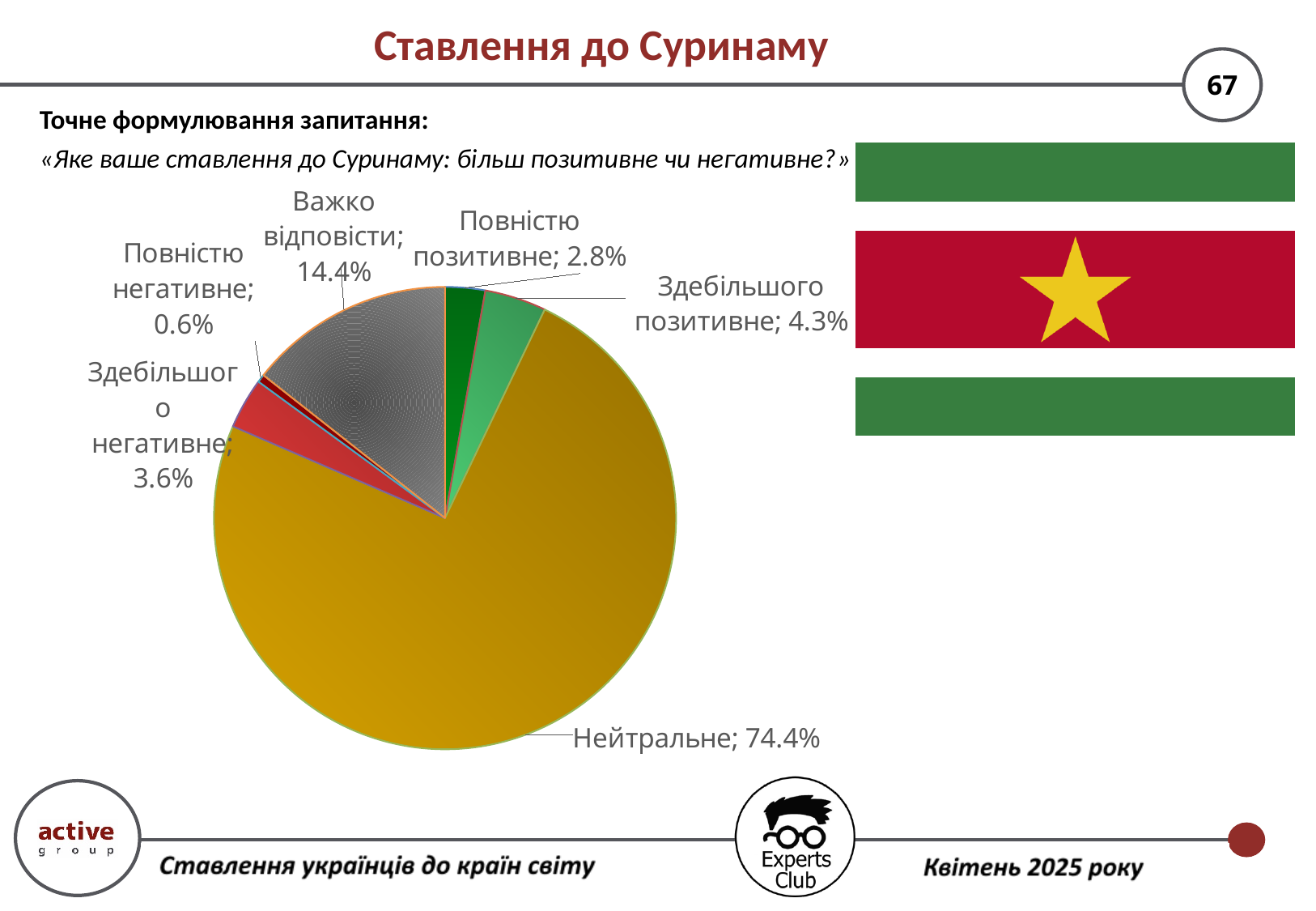
What type of chart is shown on the slide? pie chart What is the value for "Важко відповісти"? 14.4% What is the value for "Здебільшого позитивне"? 4.3% What is the value for "Повністю негативне"? 0.6% What is the title of the slide containing the chart? Ставлення до Суринаму What is the combined share of "Повністю позитивне" and "Здебільшого позитивне"? 7.1% What is the value for "Нейтральне"? 74.4% How many categories does the pie chart have? 6 Which category has the largest share of the pie? Нейтральне What is the difference between "Здебільшого позитивне" and "Повністю позитивне"? 1.5% Which category has the smallest share of the pie? Повністю негативне Which is larger: "Здебільшого негативне" or "Повністю позитивне"? Здебільшого негативне